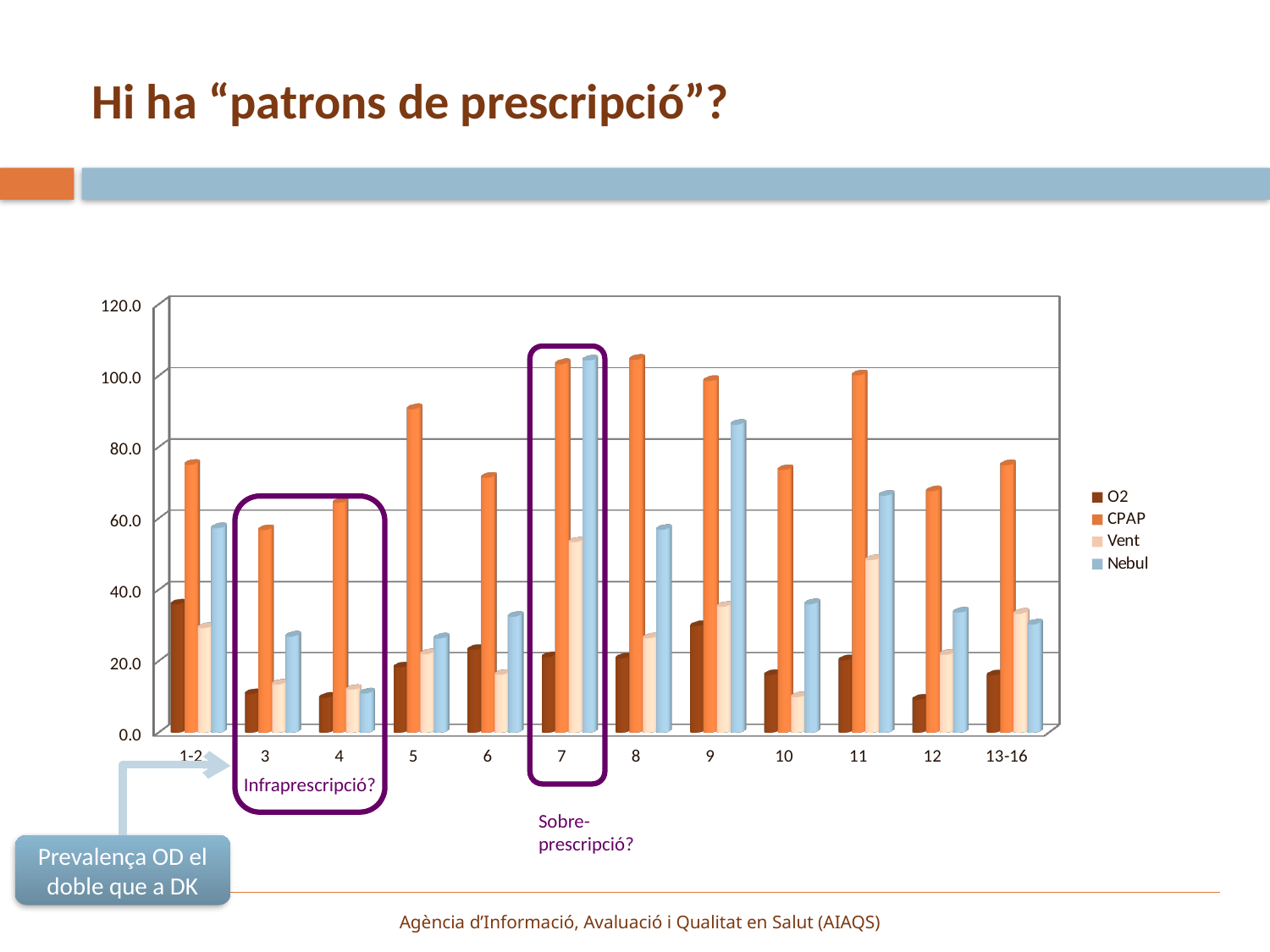
Which category has the highest O2 value? 1-2 Is the Nebul value for category 7 greater or less than 100? greater How many categories are shown on the x axis? 12 For category 9, which is larger, the CPAP value or the Nebul value? CPAP Is the CPAP value for category 7 greater or less than 100? greater Which series are listed in the legend? O2, CPAP, Vent, Nebul Is the CPAP value for category 5 greater or less than 80? greater How many series does the legend list? 4 Which category has the highest Nebul value? 7 What kind of chart is shown on the slide? bar chart